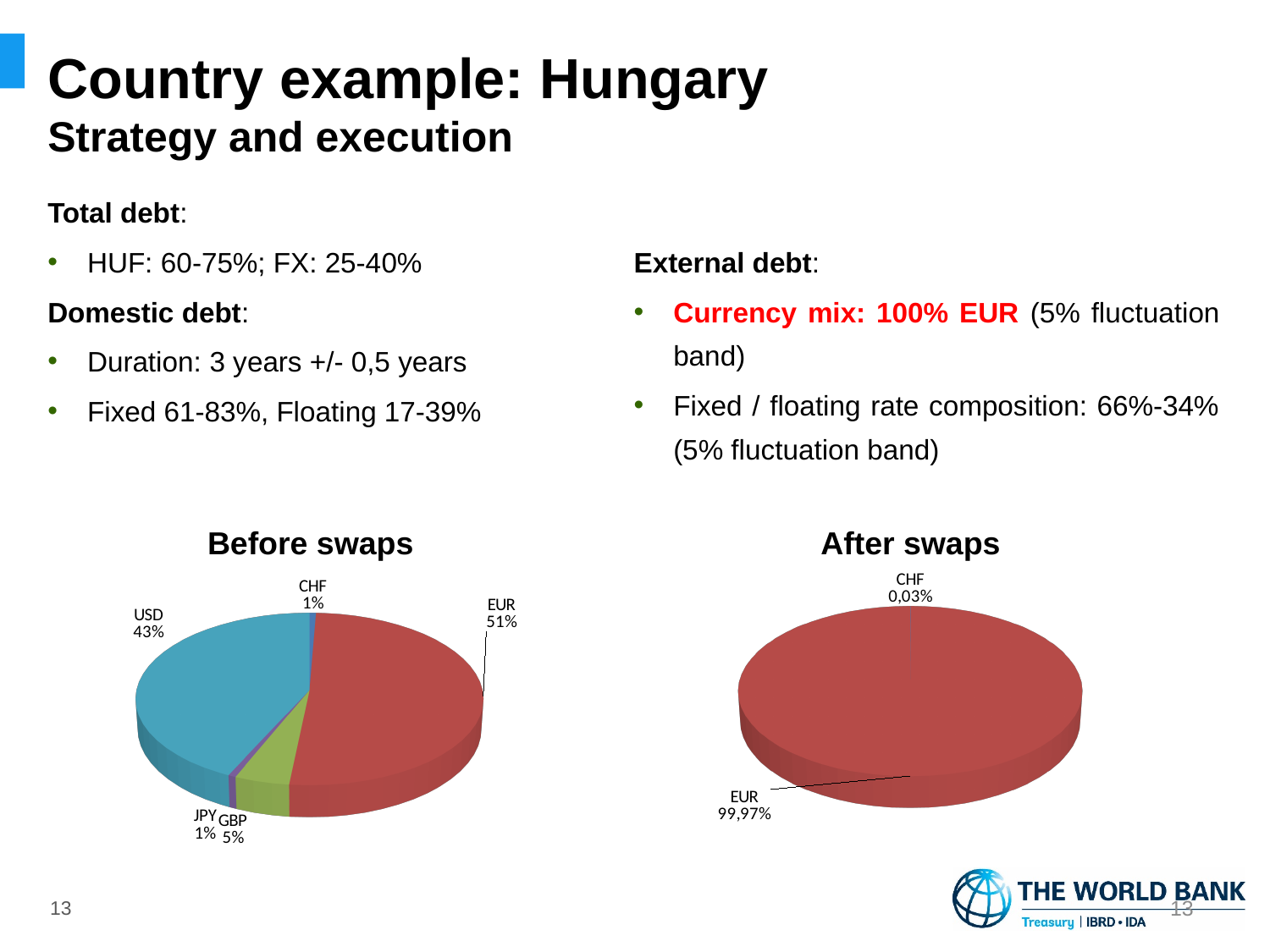
In the 'Before swaps' chart, what share does GBP have? 5% In the 'Before swaps' chart, which is larger, the USD share or the GBP share? USD In the 'After swaps' chart, what share does EUR have? 99,97% What is the title of the pie chart on the right side of the slide? After swaps How many currency slices are labelled in the 'After swaps' chart? 2 In the 'Before swaps' chart, what is the difference between the EUR share and the USD share? 8% In the 'Before swaps' chart, what share does USD have? 43% In the 'Before swaps' chart, what share does EUR have? 51% In the 'Before swaps' chart, which currency has the largest share? EUR In the 'After swaps' chart, what share does CHF have? 0,03% What kind of chart is the 'Before swaps' chart? Pie chart How many currency slices are shown in the 'Before swaps' chart? 5